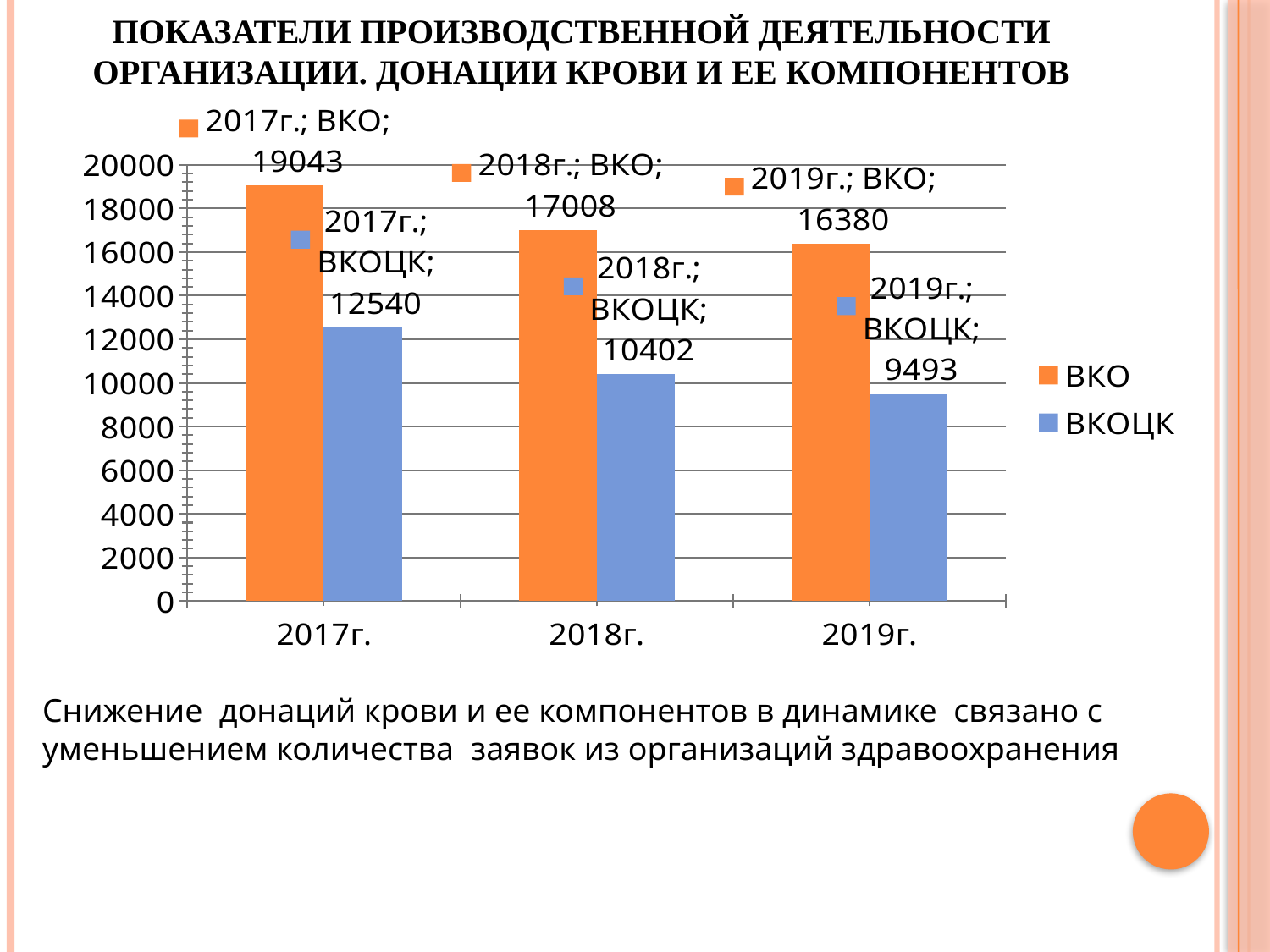
What is the value for ВКОЦК in 2019г.? 9493 Is the value for ВКОЦК in 2017г. greater or less than 14000? less Which is larger in 2018г., ВКО or ВКОЦК? ВКО What is the value for ВКОЦК in 2018г.? 10402 In which year is the ВКОЦК value lowest? 2019г. What is the difference between ВКО and ВКОЦК in 2019г.? 6887 How many series does the legend list? 2 In which year is the ВКО value highest? 2017г. What is the value for ВКО in 2017г.? 19043 Do the ВКО values rise or fall from 2017г. to 2019г.? fall What is the difference between the ВКО values for 2017г. and 2018г.? 2035 How many years are shown on the x axis? 3